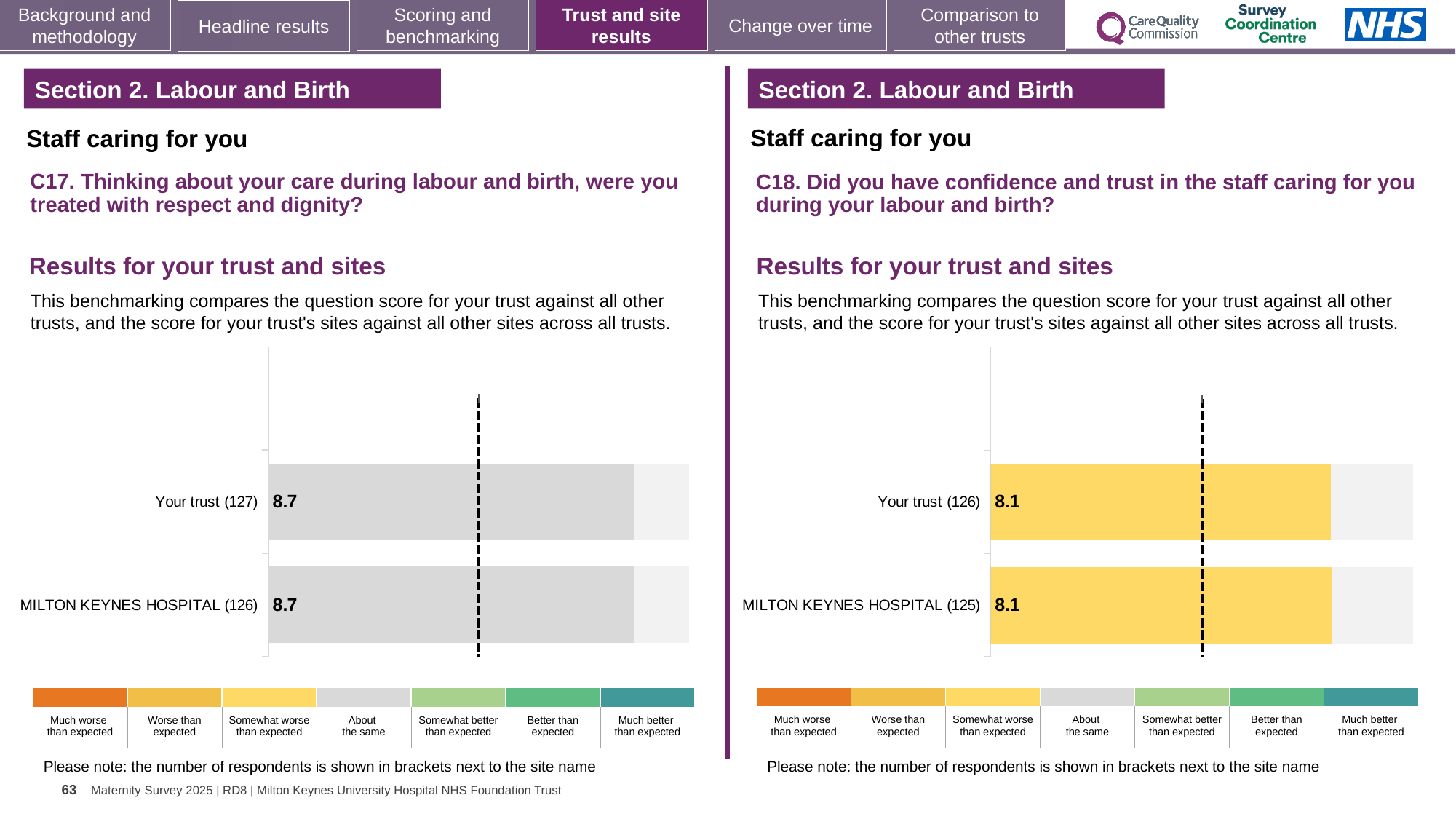
On the C17 chart (left), what is the score for MILTON KEYNES HOSPITAL (126)? 8.7 What type of chart is used on the C17 chart (left)? Bar chart On the C18 chart (right), what is the score for Your trust (126)? 8.1 On the C18 chart (right), what is the difference between the score for Your trust and the score for MILTON KEYNES HOSPITAL? 0 On the C17 chart (left), which benchmark category does the colour of the bars correspond to according to the legend? About the same How many bars are plotted on the C18 chart (right)? 2 How many bars are plotted on the C17 chart (left)? 2 On the C18 chart (right), which benchmark category does the colour of the bars correspond to according to the legend? Somewhat worse than expected On the C17 chart (left), what is the difference between the score for Your trust and the score for MILTON KEYNES HOSPITAL? 0 On the C17 chart (left), what is the score for Your trust (127)? 8.7 Is the score for Your trust on the C17 chart (left) larger or smaller than the score for Your trust on the C18 chart (right)? Larger On the C18 chart (right), what is the score for MILTON KEYNES HOSPITAL (125)? 8.1